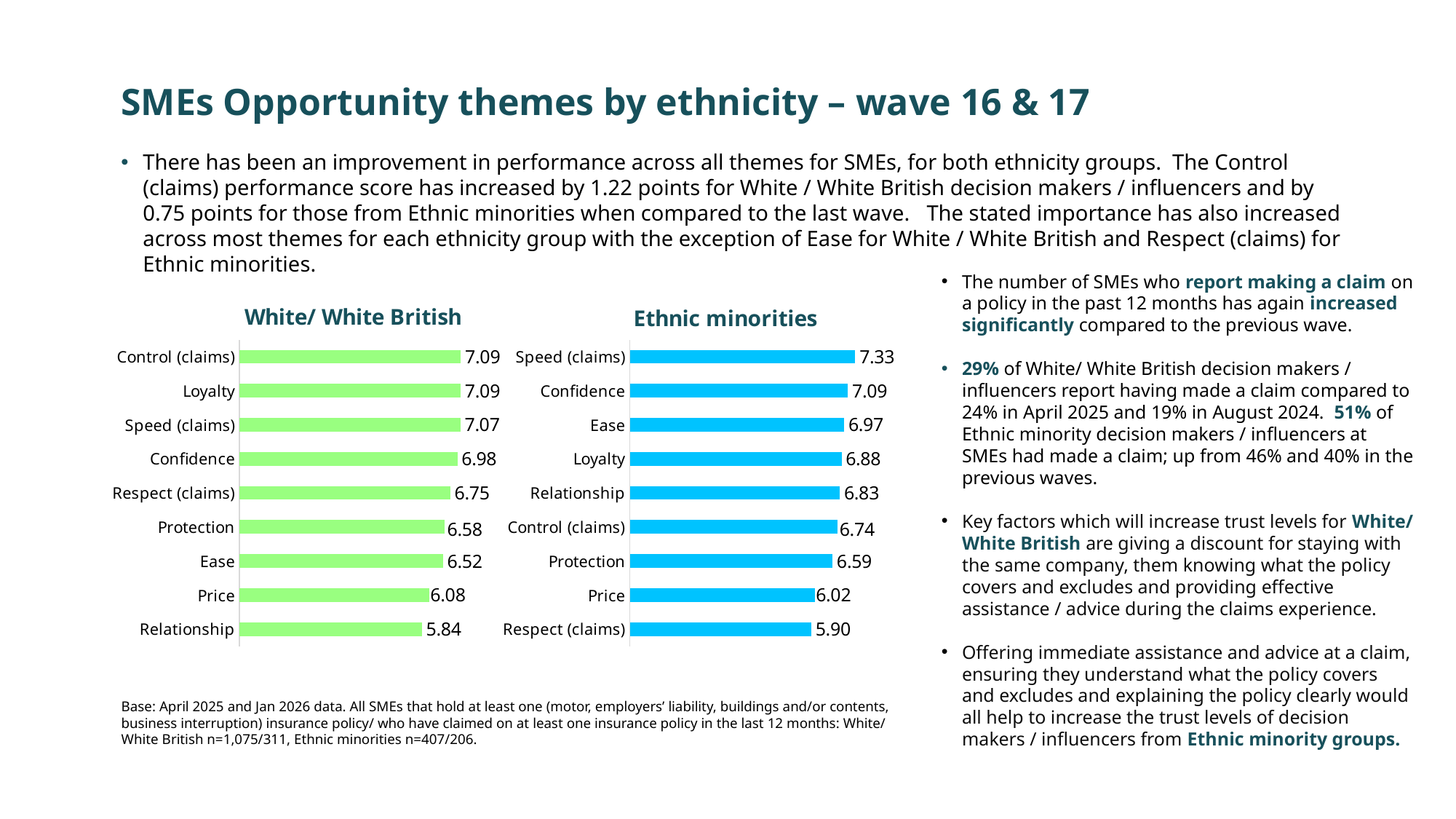
In the White/ White British chart, which is larger: the value for Protection or the value for Price? Protection What colour are the bars in the White/ White British chart? Green In the White/ White British chart, which theme has the lowest value? Relationship What type of chart is the Ethnic minorities chart? Bar chart In the Ethnic minorities chart, which theme has the lowest value? Respect (claims) In the Ethnic minorities chart, what is the value for Relationship? 6.83 In the White/ White British chart, what is the difference between the values for Control (claims) and Relationship? 1.25 Which is larger: the value for Ease in the White/ White British chart or the value for Ease in the Ethnic minorities chart? Ethnic minorities In the White/ White British chart, what is the value for Confidence? 6.98 How many themes are shown in the White/ White British chart? 9 In the Ethnic minorities chart, which theme has the highest value? Speed (claims) In the Ethnic minorities chart, what is the difference between the values for Speed (claims) and Price? 1.31